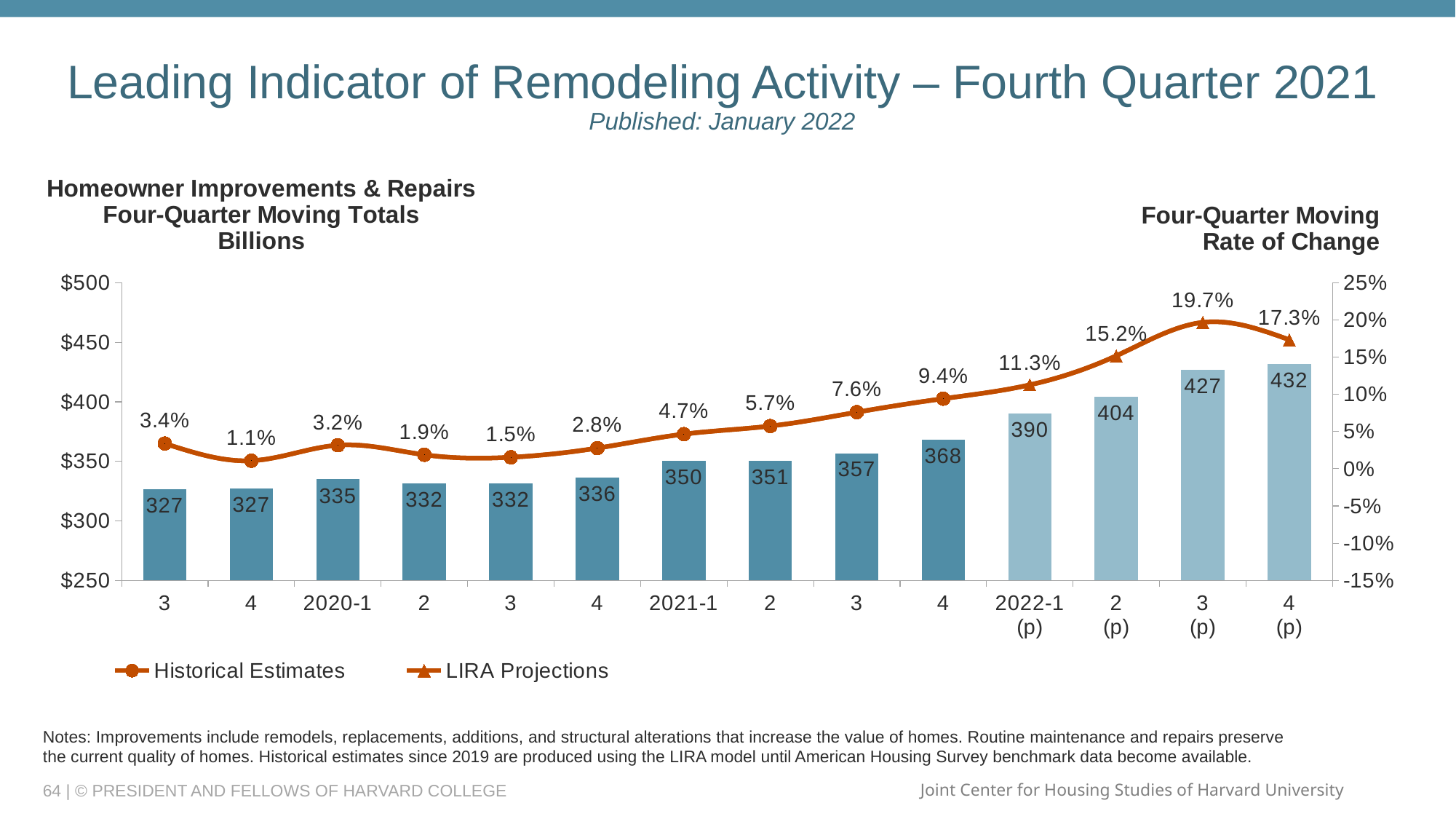
How many series does the legend list? 2 Do the four-quarter moving totals rise or fall from 2021-1 to 2022-4 (p)? rise Which quarter has the lowest four-quarter moving rate of change? 2019-4 Is the four-quarter moving total for 2022-2 (p) greater or less than $400 billion? greater What is the difference between the four-quarter moving totals for 2022-4 (p) and 2022-1 (p)? 42 What is the four-quarter moving total for 2022-4 (p)? 432 How many quarters are shown on the x axis of the chart? 14 Which quarter has the highest four-quarter moving rate of change? 2022-3 (p) Which is larger, the four-quarter moving total for 2021-4 or for 2020-4? 2021-4 What is the four-quarter moving rate of change for 2022-3 (p)? 19.7% What are the two series named in the legend? Historical Estimates and LIRA Projections What is the four-quarter moving total (in billions) for 2021-1? 350